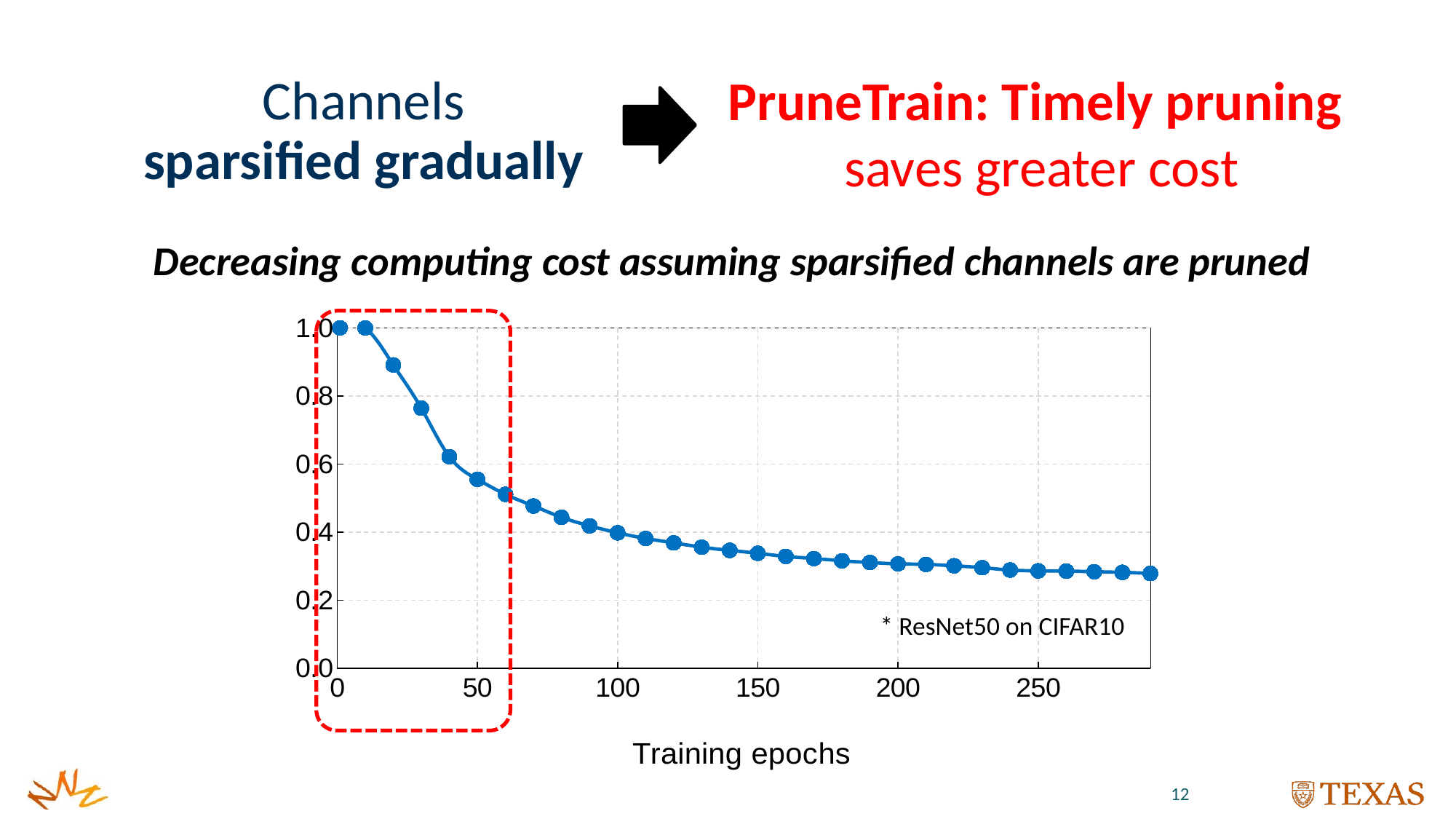
What model and dataset does the annotation inside the chart say the data is for? ResNet50 on CIFAR10 Do the plotted values rise or fall as training epochs increase? fall Is the value at training epoch 40 greater or less than 0.4? greater Is the value at training epoch 20 greater or less than 0.8? greater Is the value at training epoch 100 greater or less than 0.6? less How many data points are plotted on the line? 30 What is the label of the x axis? Training epochs What kind of chart is shown on the slide? line chart Which is larger, the value at training epoch 50 or the value at training epoch 150? training epoch 50 What is the plotted value at training epoch 0? 1.0